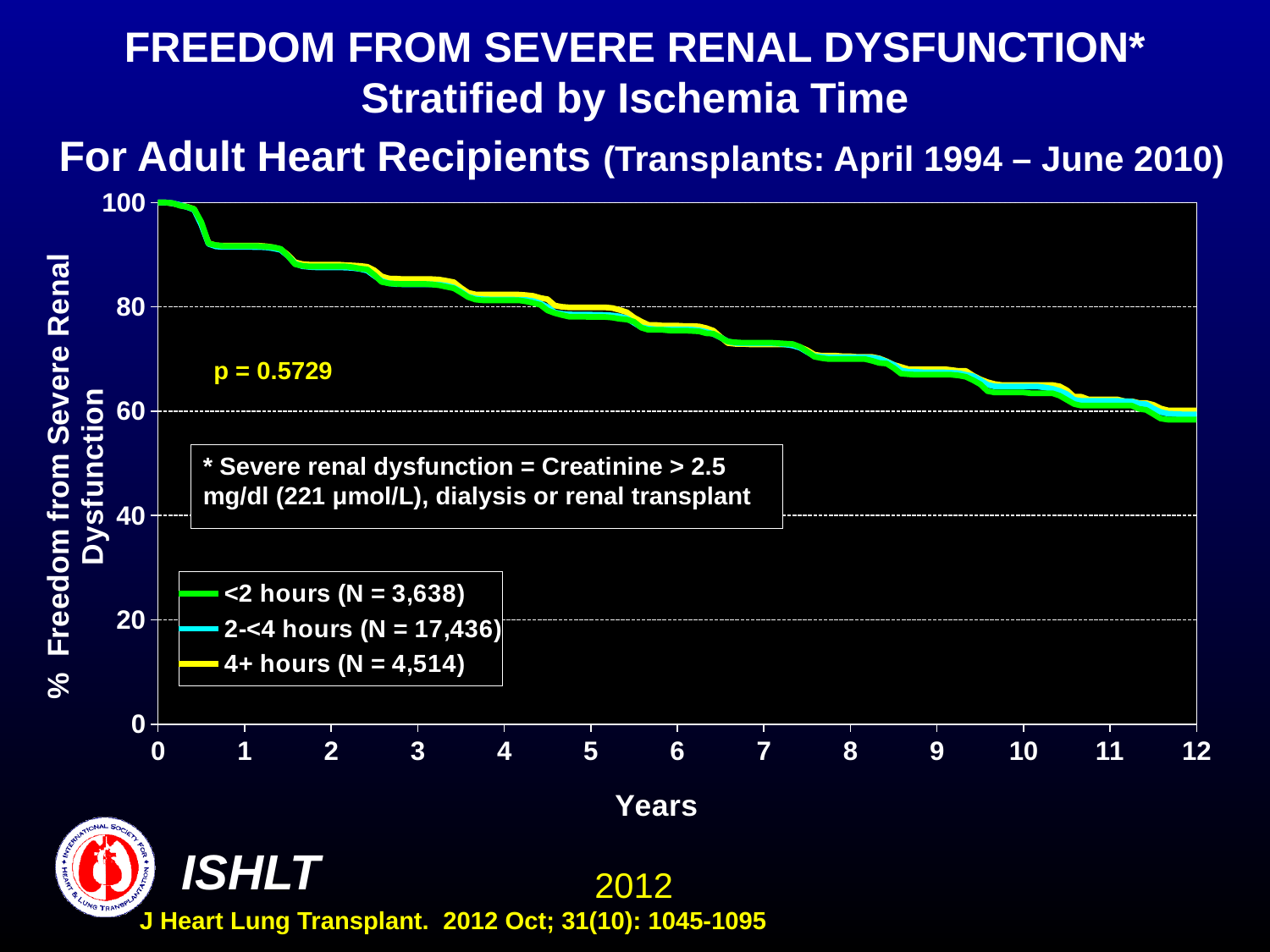
Is the value for the <2 hours group at year 1 greater or less than 80? greater How many series does the legend list? 3 What p-value is printed on the chart? p = 0.5729 What is the N for the 2-<4 hours group shown in the legend? 17,436 Do the curves rise or fall as the years increase along the x axis? fall Is the value for the 4+ hours group at year 3 greater or less than 80? greater Is the value for the 2-<4 hours group at year 12 greater or less than 80? less What kind of chart is shown on the slide? line chart